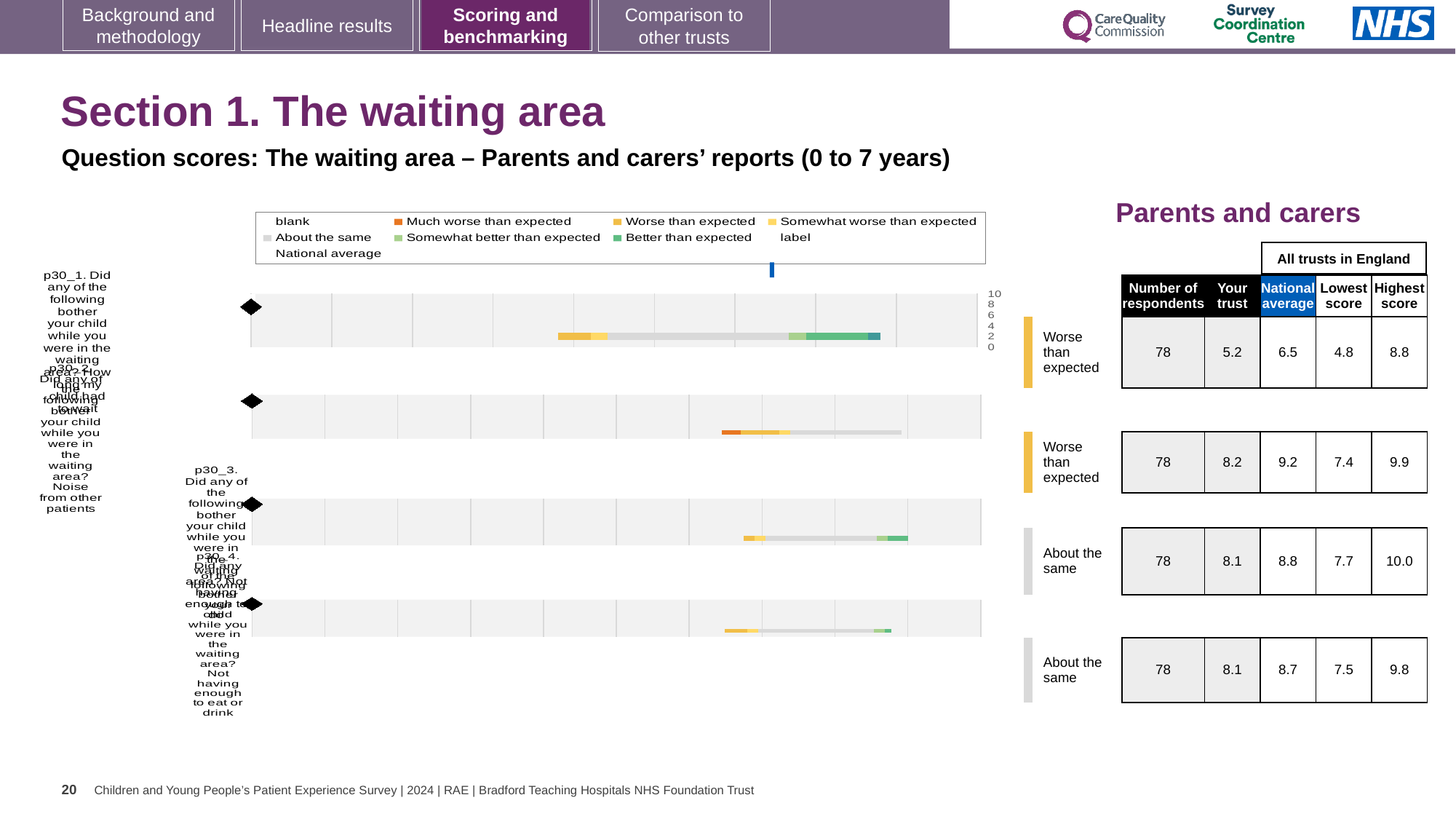
In the chart legend, what colour represents 'Much worse than expected'? orange Which row of the table has the lowest 'Your trust' score? the first row (5.2) Which row of the table has the highest 'Highest score' value? the third row (10.0) What kind of chart is shown on the left of the slide? bar chart In the table on the right, what is the national average in the second row? 9.2 In the table on the right, what is the number of respondents in the first row? 78 In the first row of the table, which is larger: the 'Your trust' score or the national average? National average In the table on the right, what is the lowest score in the fourth row? 7.5 How many question rows (bars) does the chart on the left show? 4 In the table on the right, what is the highest score in the third row? 10.0 In the first row of the table, what is the difference between the highest score and the lowest score? 4.0 In the table on the right, what is the 'Your trust' score in the first row? 5.2